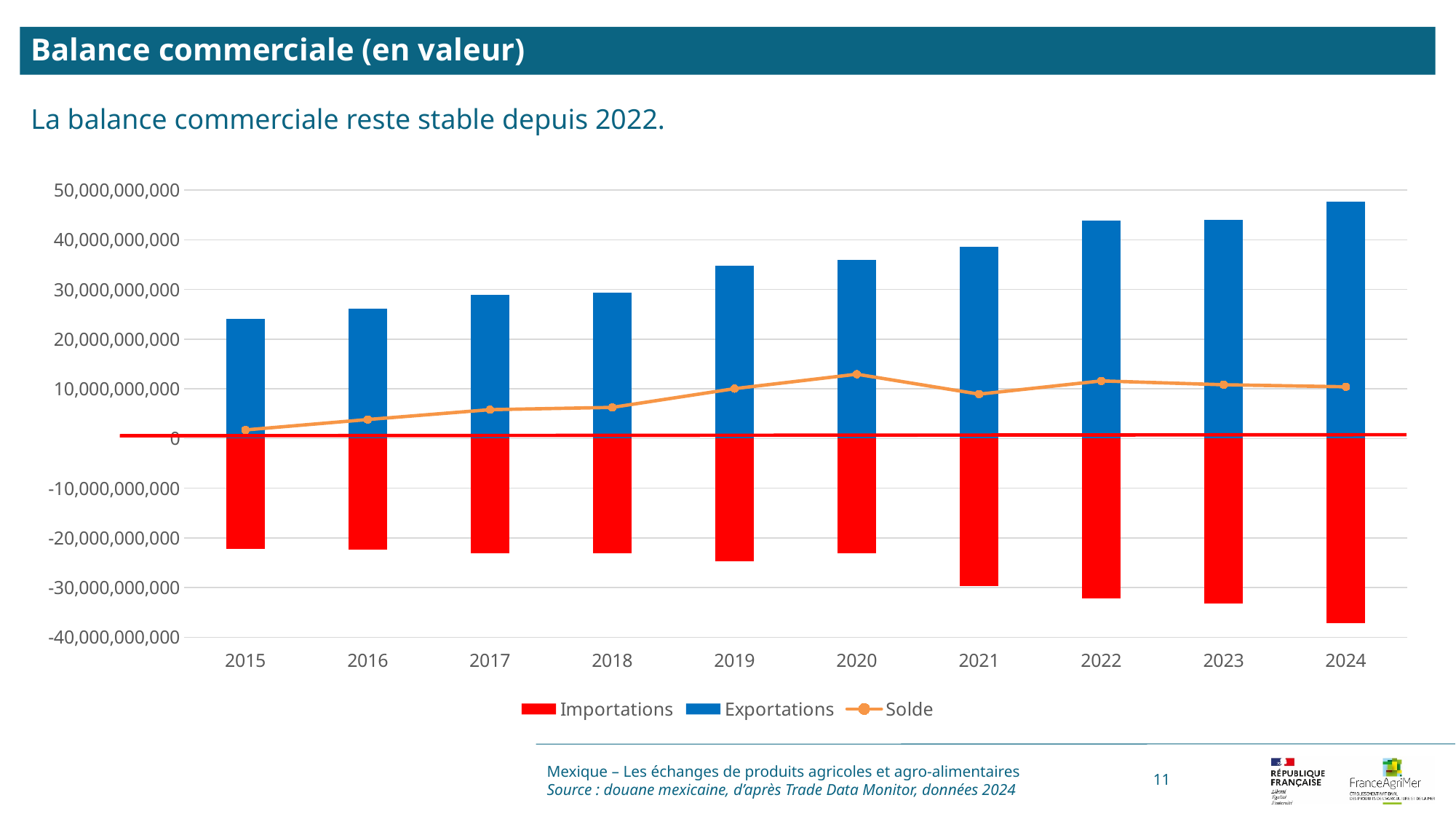
How many series does the chart legend list? 3 In which year is the Solde line at its lowest point? 2015 In which year does the Solde line reach its highest point? 2020 How many years are shown on the x axis of the chart? 10 Is the Exportations value for 2024 greater or less than 40,000,000,000? greater In which year is the Exportations bar the highest? 2024 Do the Exportations values generally rise or fall from 2015 to 2024? rise What are the three series listed in the chart legend? Importations, Exportations, Solde Which year has the larger Exportations value, 2019 or 2022? 2022 In which year is the Exportations bar the lowest? 2015 Is the Exportations value for 2015 greater or less than 30,000,000,000? less What kind of chart is shown on the slide? A combined bar and line chart